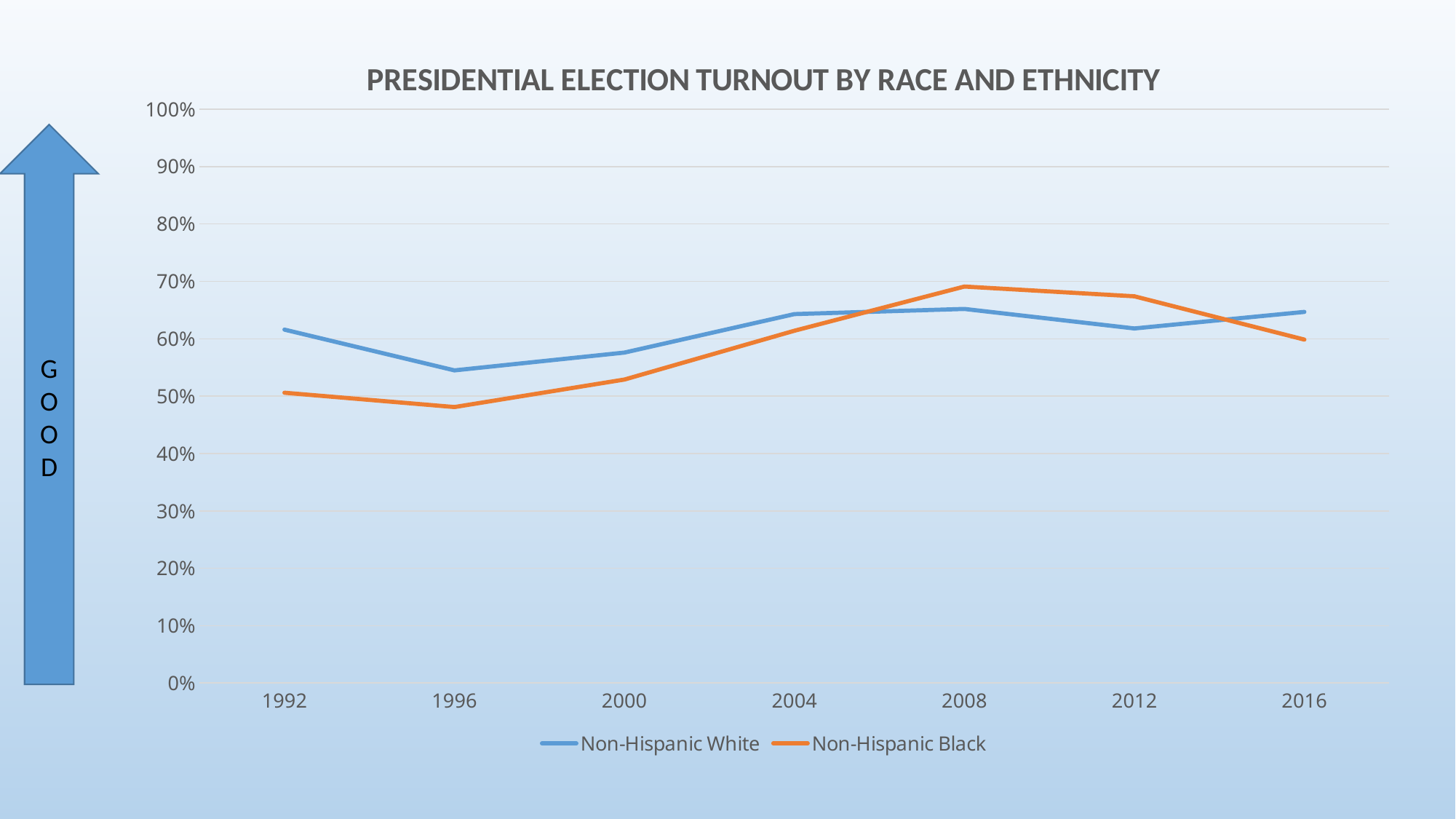
How many election years are plotted on the x axis? 7 How many series does the legend list? 2 In which year does the Non-Hispanic Black turnout reach its highest point? 2008 Does the Non-Hispanic Black turnout rise or fall between 1996 and 2008? rise What kind of chart is shown on the slide? line chart In which year is the Non-Hispanic White turnout at its lowest? 1996 In 2008, which series has the higher turnout, Non-Hispanic White or Non-Hispanic Black? Non-Hispanic Black In 1992, which series has the higher turnout, Non-Hispanic White or Non-Hispanic Black? Non-Hispanic White What is the title of the chart? PRESIDENTIAL ELECTION TURNOUT BY RACE AND ETHNICITY Is the Non-Hispanic Black turnout in 2008 greater or less than 60%? greater In which year is the Non-Hispanic Black turnout at its lowest? 1996 Is the Non-Hispanic Black turnout in 1992 greater or less than 60%? less